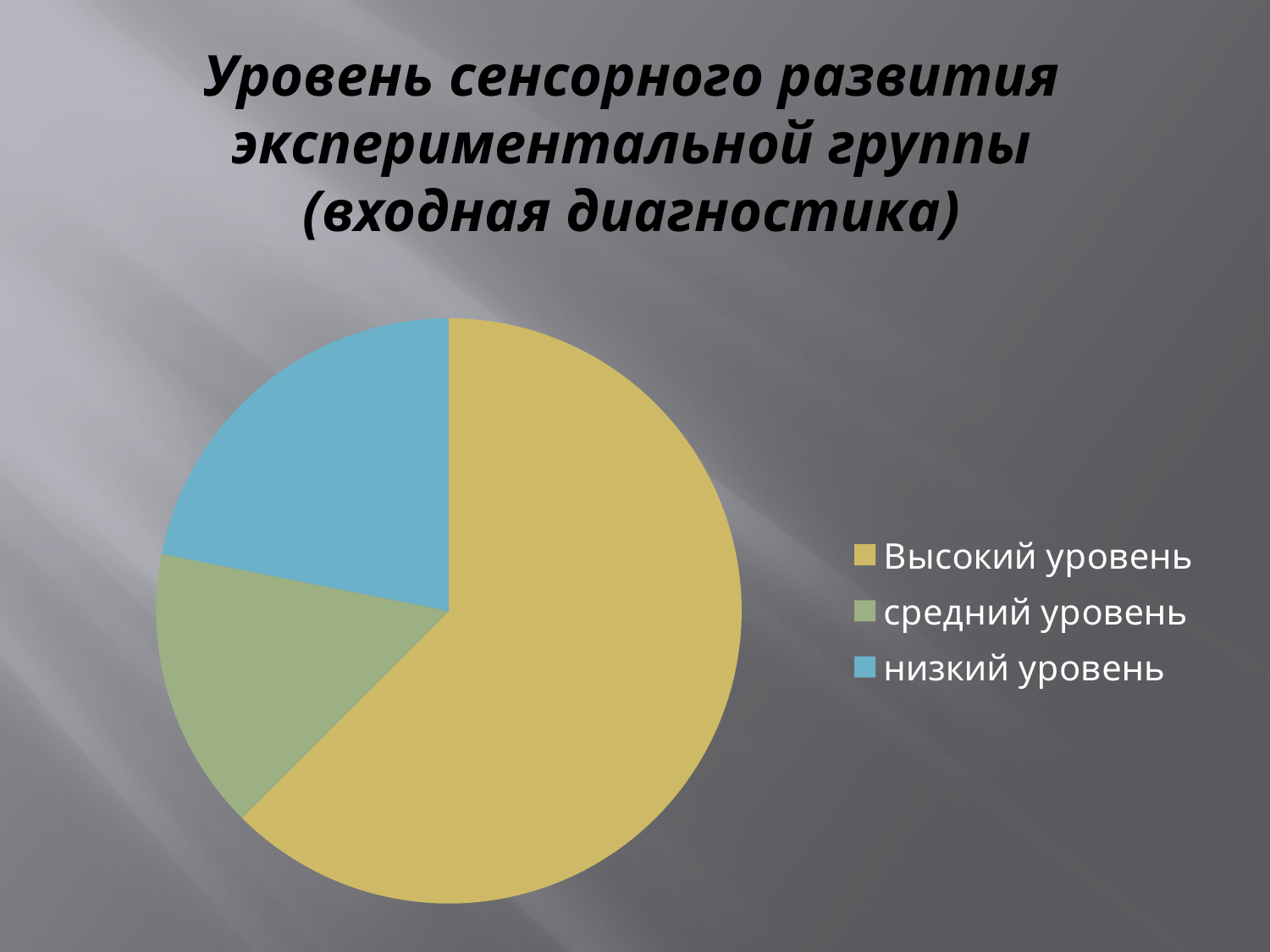
How many slices does the pie chart have? 3 Which colour represents низкий уровень in the pie chart? blue Which slice is larger: Высокий уровень or низкий уровень? Высокий уровень How many entries does the legend list? 3 Which category has the largest slice of the pie? Высокий уровень What is the title of the chart? Уровень сенсорного развития экспериментальной группы (входная диагностика) What kind of chart is shown on the slide? pie chart Which category has the smallest slice of the pie? средний уровень Which slice is larger: Высокий уровень or средний уровень? Высокий уровень